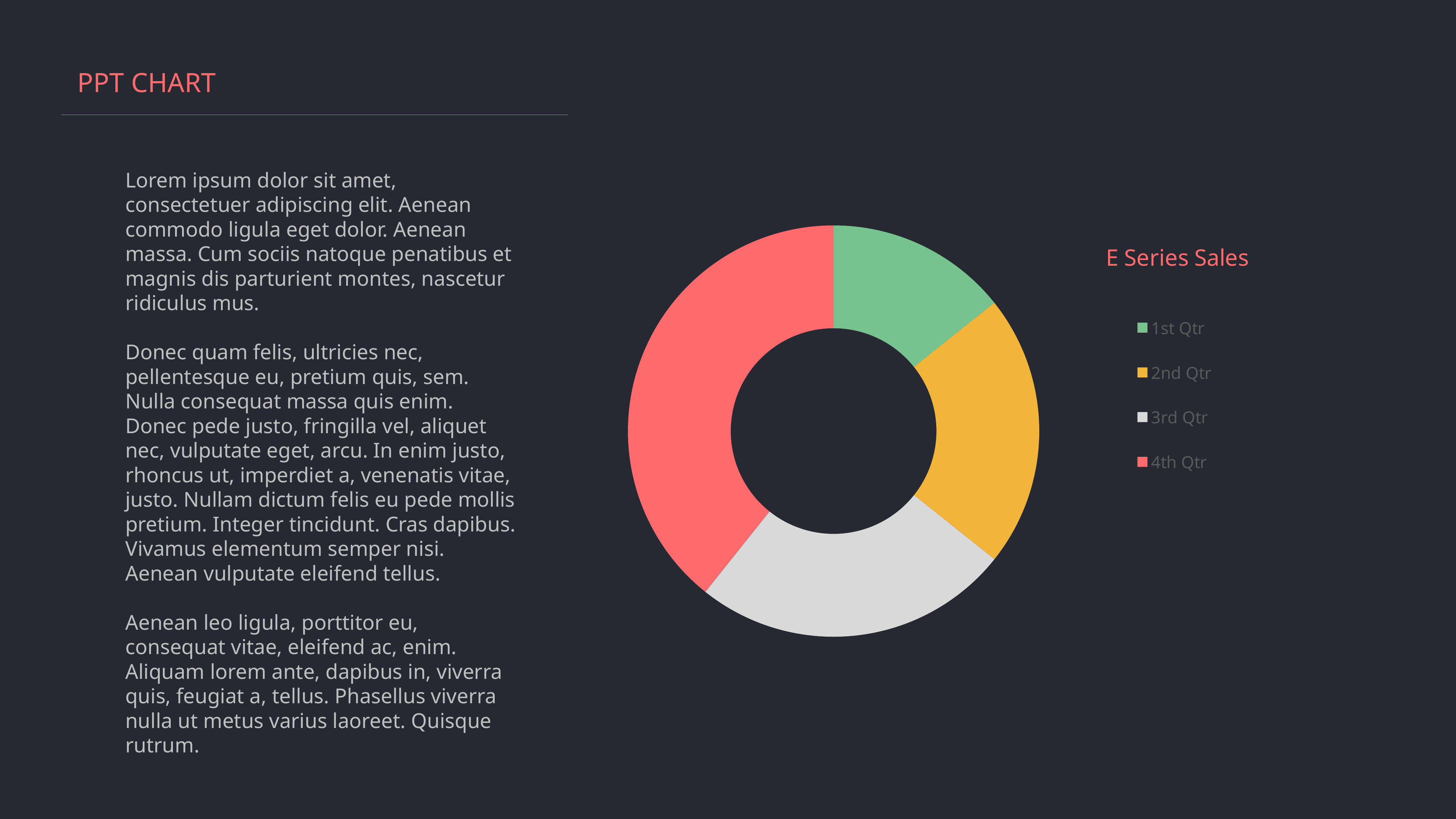
How many entries does the chart legend list? 4 Which category has the largest slice of the doughnut? 4th Qtr What colour represents 2nd Qtr in the chart? Yellow What kind of chart is shown on the slide? Doughnut chart Which category has the smallest slice of the doughnut? 1st Qtr Which slice is larger, 4th Qtr or 3rd Qtr? 4th Qtr What is the title of the chart? E Series Sales Which slice is larger, 1st Qtr or 3rd Qtr? 3rd Qtr How many categories does the chart show? 4 Which slice is larger, 2nd Qtr or 1st Qtr? 2nd Qtr